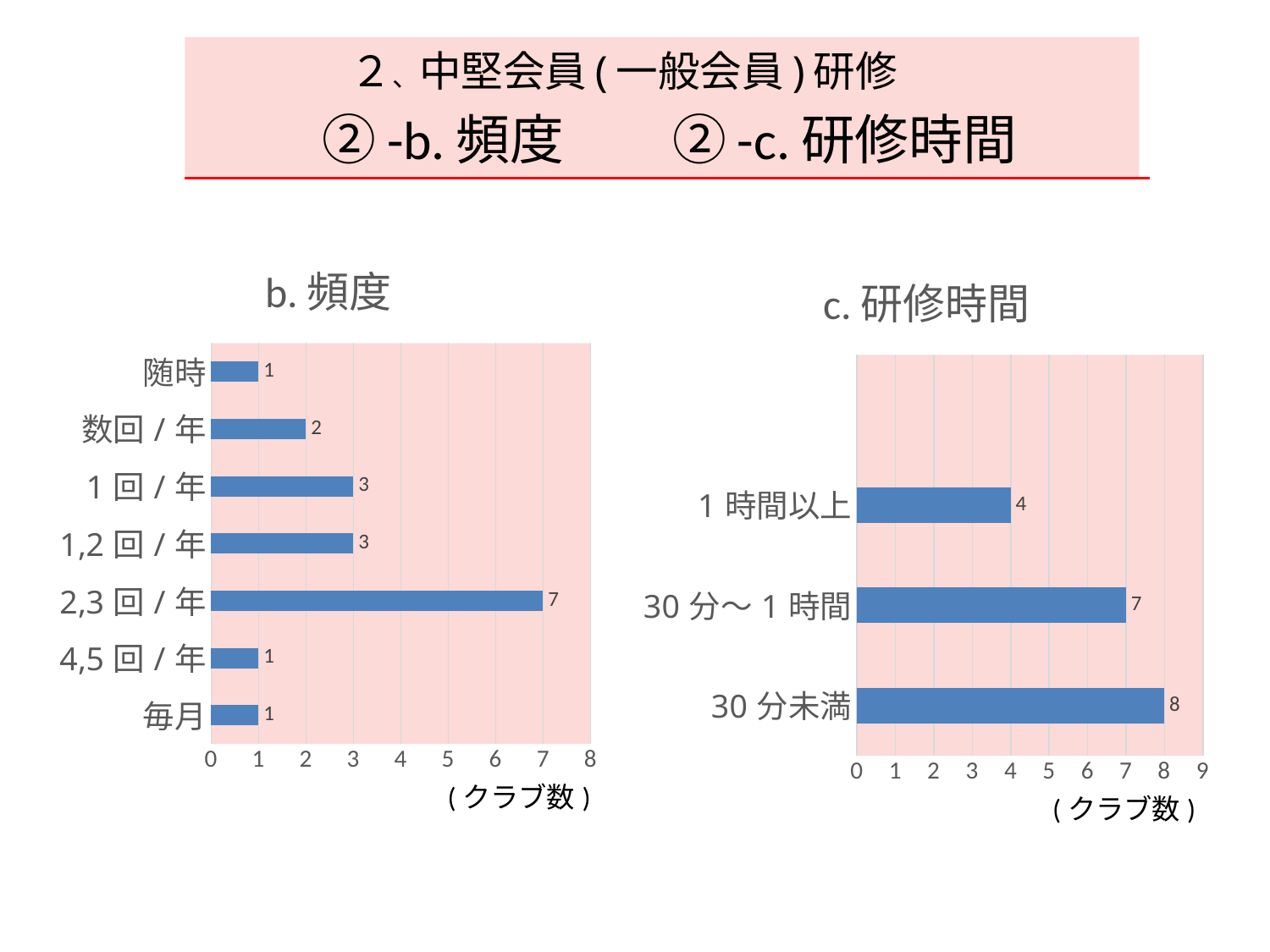
In the 'c. 研修時間' chart, what is the difference between the values for 30分未満 and 30分〜1時間? 1 In the 'c. 研修時間' chart, what is the value for 30分未満? 8 In the 'c. 研修時間' chart, how many categories are shown? 3 In the 'b. 頻度' chart, how many categories are shown? 7 In the 'b. 頻度' chart, which category has the highest value? 2,3回/年 In the 'b. 頻度' chart, what is the value for 数回/年? 2 In the 'b. 頻度' chart, which is larger, the value for 数回/年 or the value for 毎月? 数回/年 What kind of chart is the 'c. 研修時間' chart? Bar chart In the 'c. 研修時間' chart, what is the value for 1時間以上? 4 In the 'b. 頻度' chart, what is the difference between the values for 2,3回/年 and 1回/年? 4 In the 'b. 頻度' chart, what is the value for 2,3回/年? 7 In the 'c. 研修時間' chart, which category has the lowest value? 1時間以上